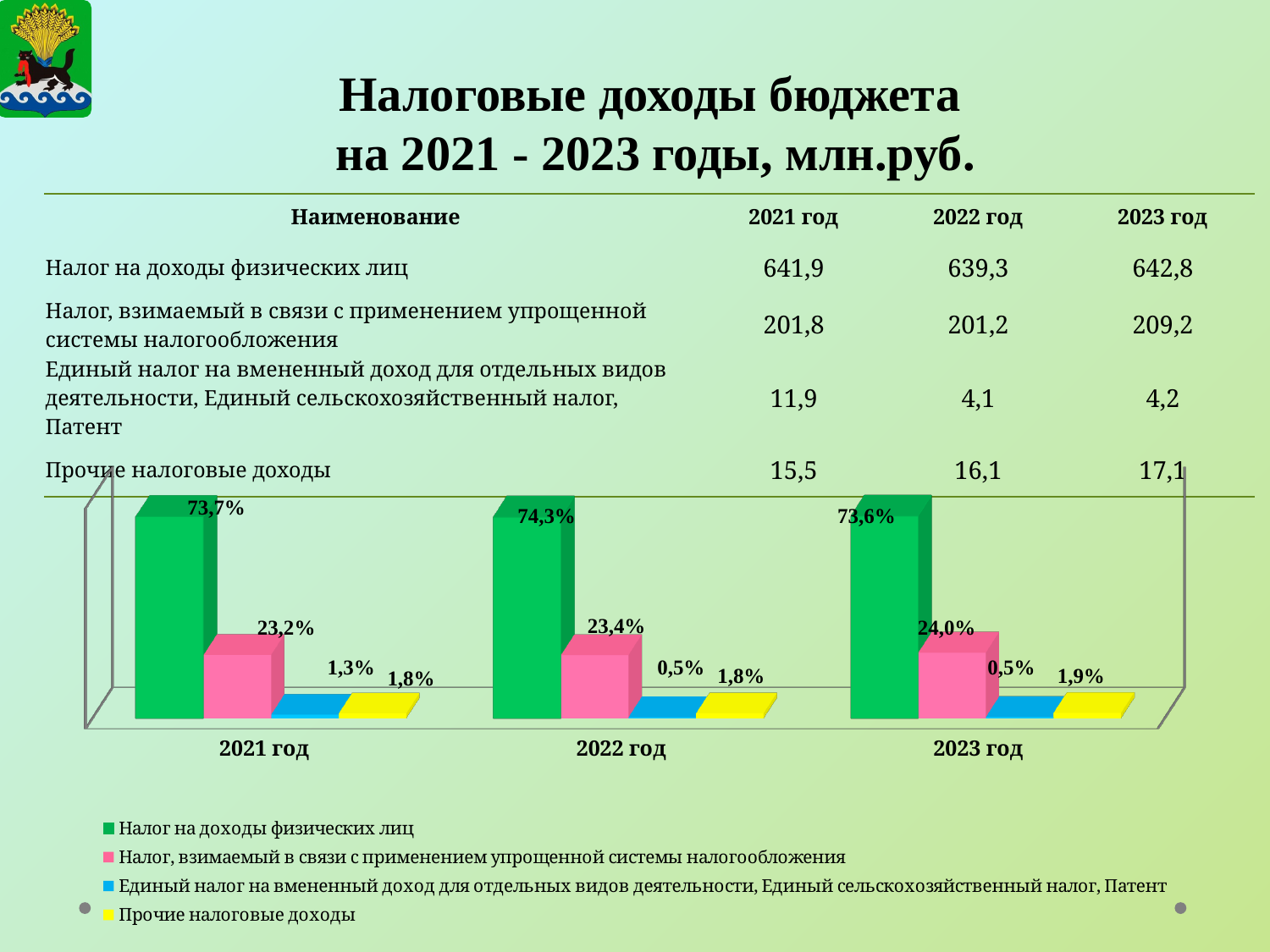
How many year groups are shown on the x axis of the chart? 3 In 2021 год, which is larger on the chart: the share of 'Прочие налоговые доходы' or the share of 'Единый налог на вмененный доход для отдельных видов деятельности, Единый сельскохозяйственный налог, Патент'? Прочие налоговые доходы Which colour represents 'Прочие налоговые доходы' in the chart? Yellow What percentage does the chart show for 'Налог на доходы физических лиц' in 2021 год? 73,7% In which year is the share of 'Налог на доходы физических лиц' the highest on the chart? 2022 год How many series does the chart legend list? 4 What kind of chart is shown on the slide? Bar chart Which series has the smallest share in 2023 год on the chart? Единый налог на вмененный доход для отдельных видов деятельности, Единый сельскохозяйственный налог, Патент What percentage does the chart show for 'Налог, взимаемый в связи с применением упрощенной системы налогообложения' in 2023 год? 24,0% What percentage does the chart show for 'Единый налог на вмененный доход для отдельных видов деятельности, Единый сельскохозяйственный налог, Патент' in 2021 год? 1,3% What percentage does the chart show for 'Прочие налоговые доходы' in 2022 год? 1,8% What is the difference between the share of 'Налог на доходы физических лиц' and 'Налог, взимаемый в связи с применением упрощенной системы налогообложения' in 2022 год? 50,9%